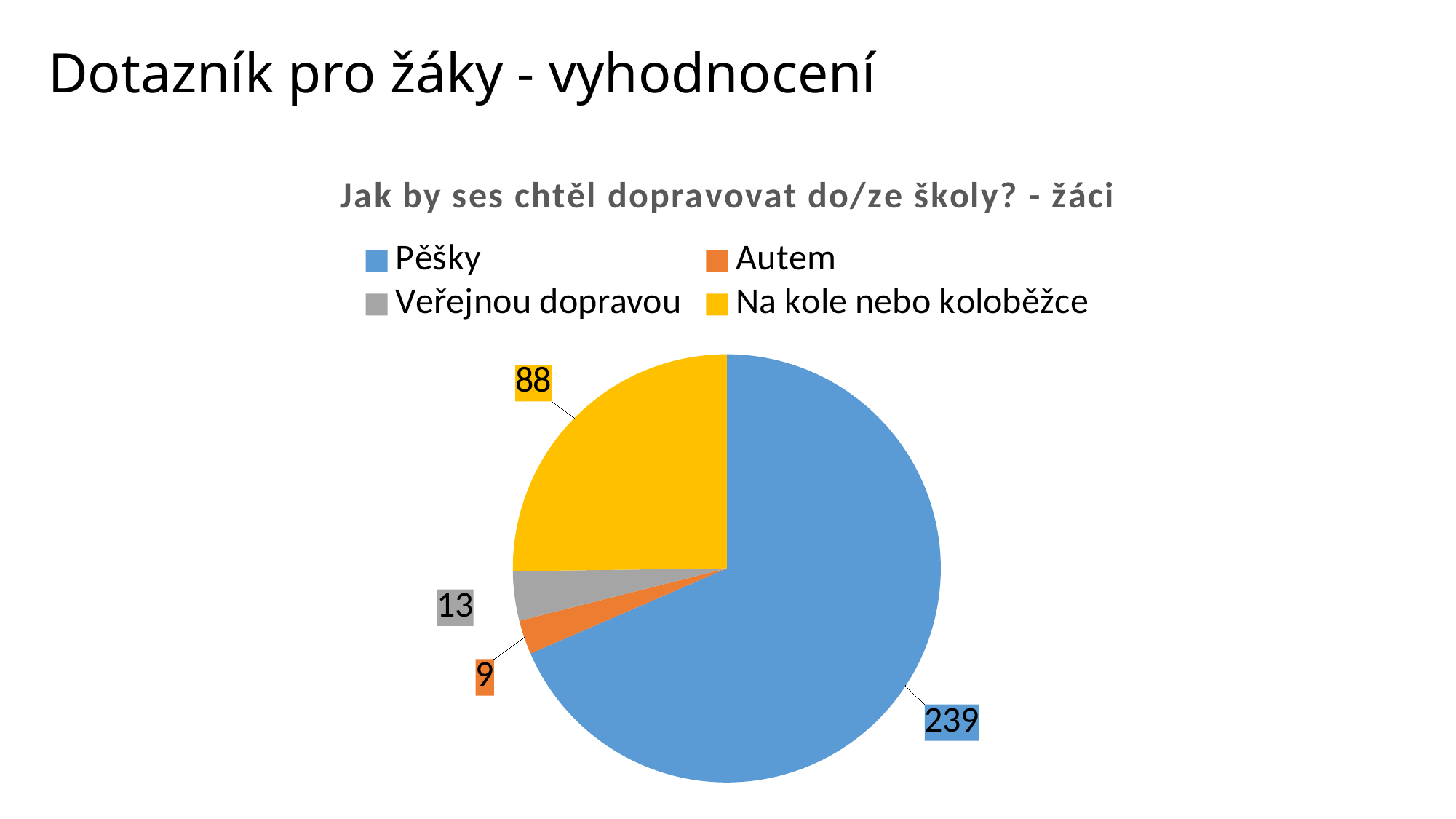
What is the value for Autem? 9 Which category has the highest value? Pěšky What is the value for Pěšky? 239 What is the difference between the values for Pěšky and Na kole nebo koloběžce? 151 What is the value for Na kole nebo koloběžce? 88 What is the value for Veřejnou dopravou? 13 What is the title of the chart? Jak by ses chtěl dopravovat do/ze školy? - žáci How many categories does the legend list? 4 What kind of chart is shown on the slide? pie chart Which category has the lowest value? Autem Which is larger, the value for Veřejnou dopravou or the value for Autem? Veřejnou dopravou What is the total of all slices in the pie chart? 349